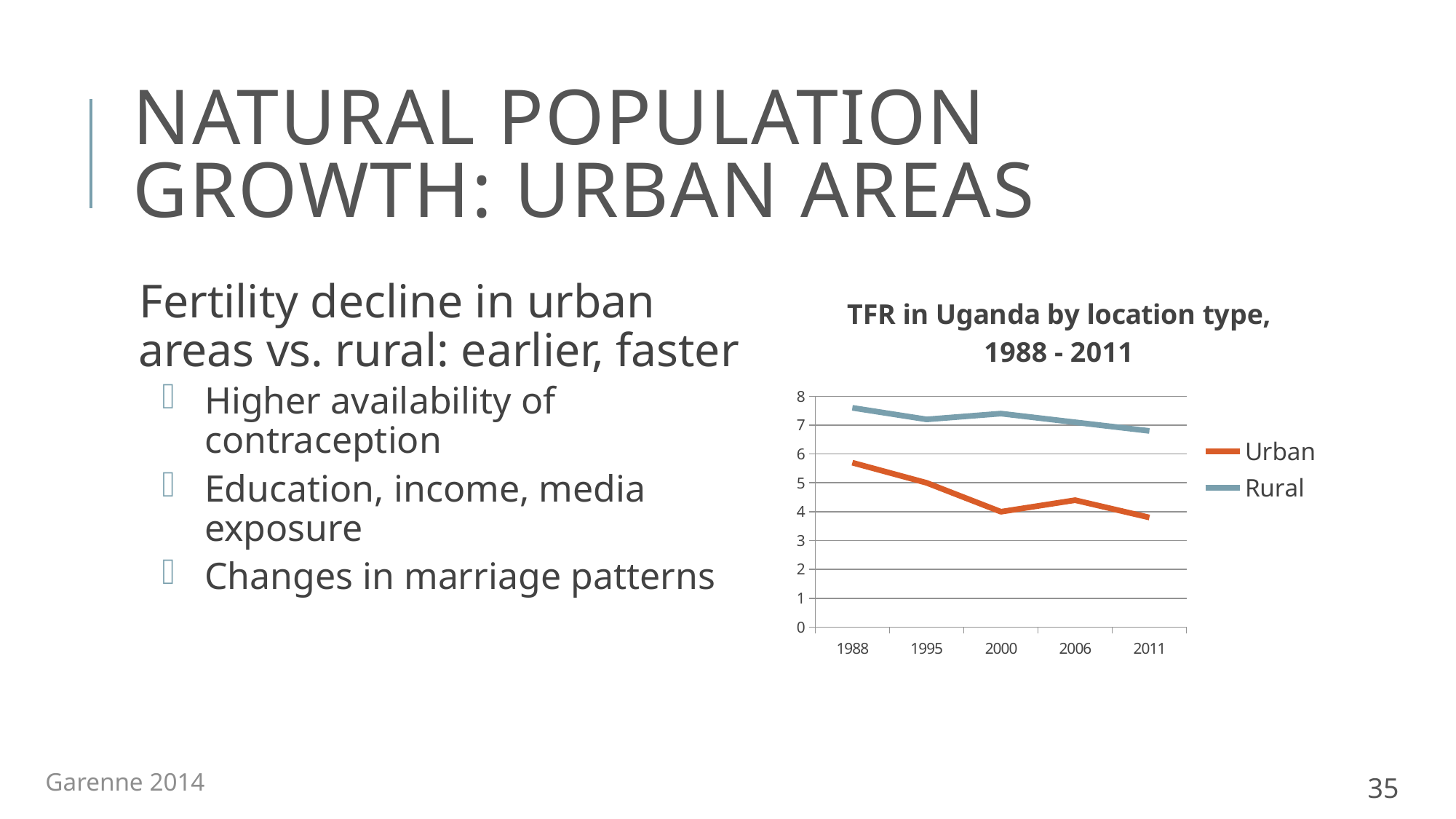
How many years are plotted along the x axis of the chart? 5 Is the Urban value for 1988 greater or less than 5? greater For the Urban series, which year has the larger value, 2000 or 2006? 2006 How many series does the legend of the chart list? 2 Is the Rural value for 2011 greater or less than 6? greater What is the title of the chart? TFR in Uganda by location type, 1988 - 2011 Is the Urban value for 2006 greater or less than 4? greater Which series is drawn with the orange line? Urban In which year is the Urban series at its highest? 1988 In 1988, which series has the higher value, Urban or Rural? Rural Does the Rural series overall rise or fall from 1988 to 2011? fall What kind of chart is shown on the slide? line chart